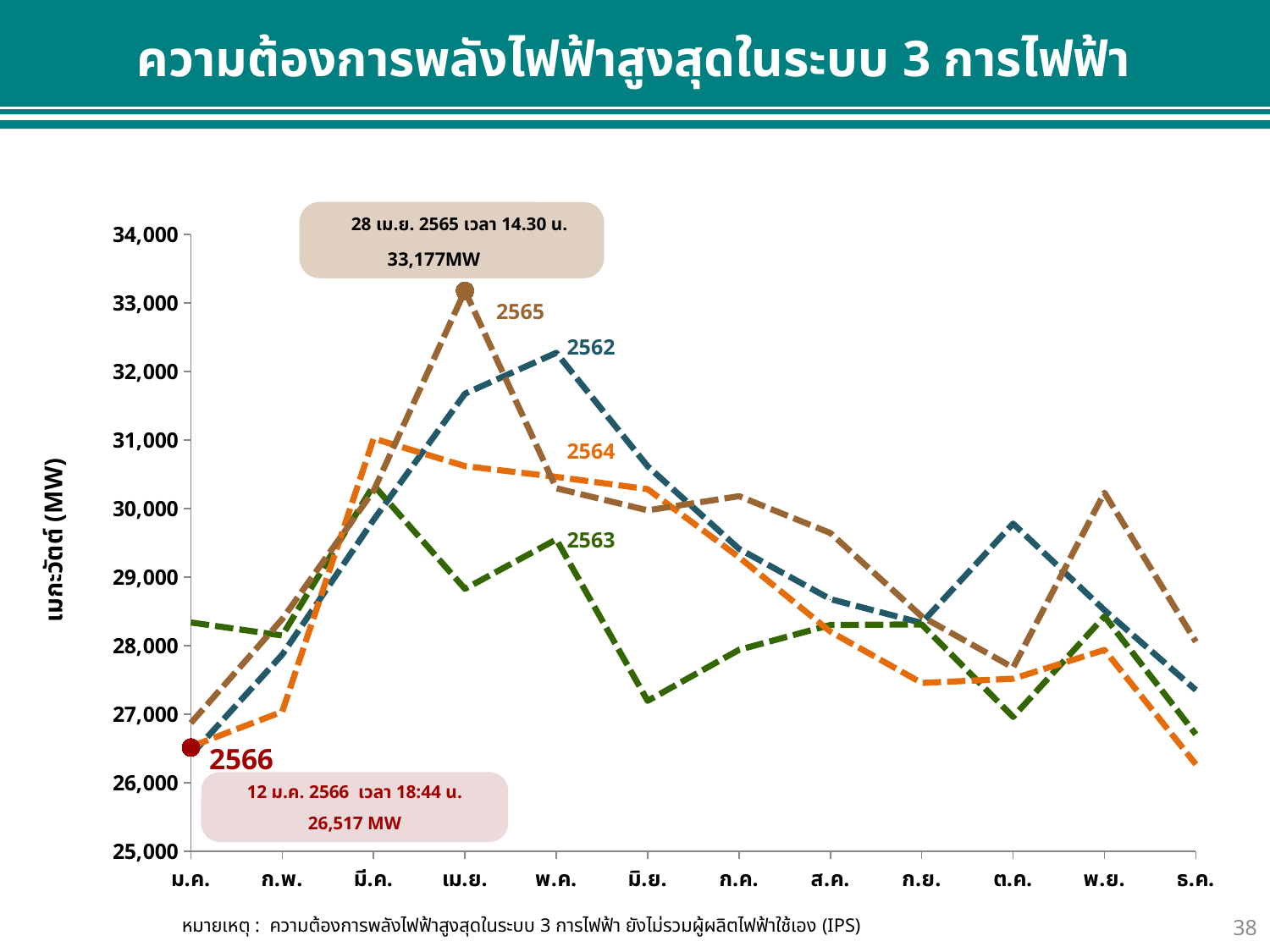
What is the value labelled for the 2566 series in ม.ค.? 26,517 MW Which series reaches the highest value on the chart? 2565 In which month does the 2565 series reach its highest value? เม.ย. Is the value for the 2562 series in เม.ย. greater or less than 31,000? greater In มิ.ย., which series has the larger value, 2563 or 2564? 2564 How many months are shown along the x axis? 12 How many yearly series are labelled on the chart? 5 What type of chart is shown on the slide? Line chart What is the difference between the labelled 2565 peak (33,177MW) and the labelled 2566 value (26,517 MW)? 6,660 MW Does the 2565 series rise or fall from ม.ค. to เม.ย.? Rise What is the peak value labelled for the 2565 series in เม.ย.? 33,177MW Is the value for the 2563 series in มิ.ย. greater or less than 28,000? less